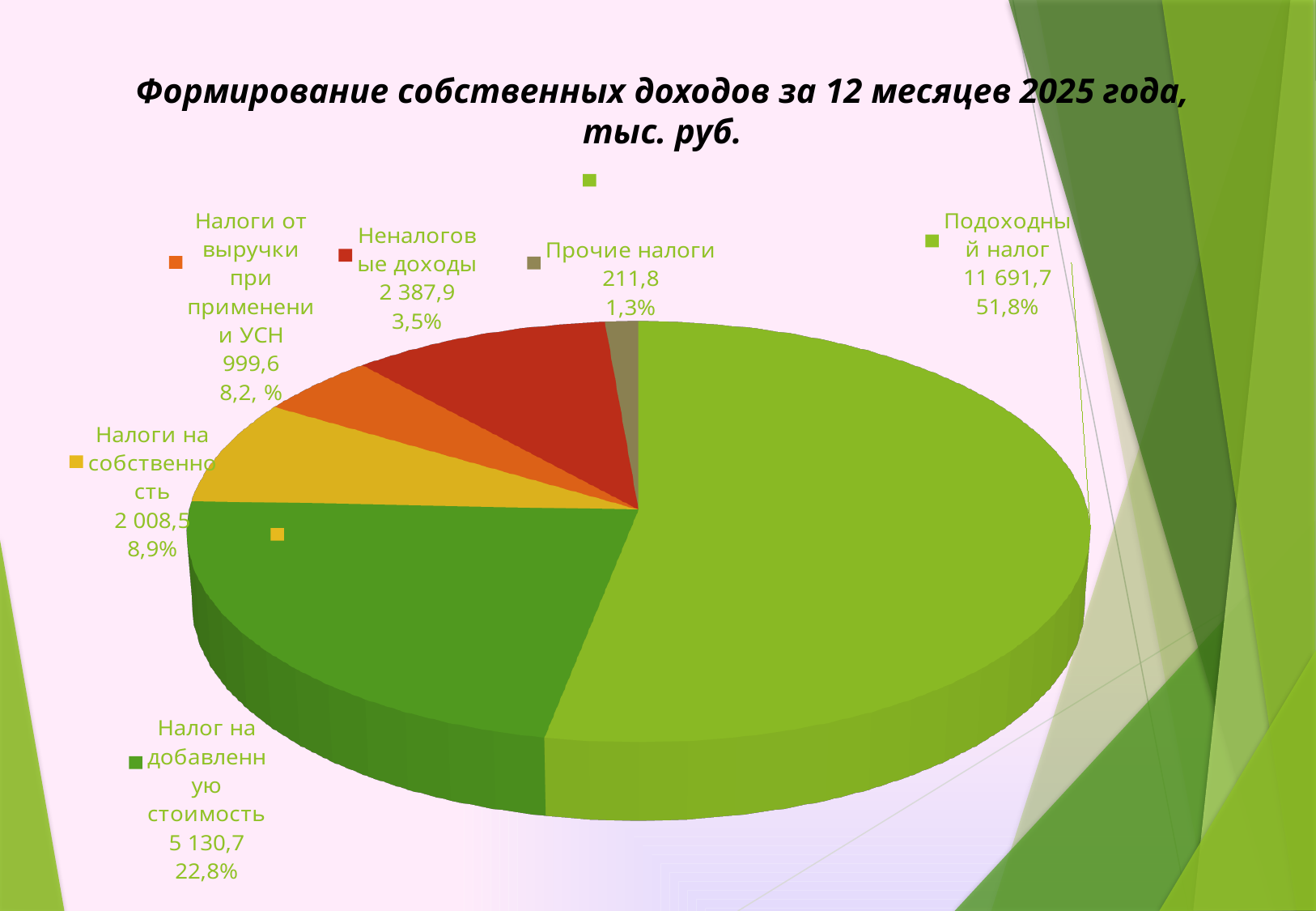
What is the value for Налог на добавленную стоимость? 5 130,7 What is the value for Прочие налоги? 211,8 Which is larger: Неналоговые доходы or Налоги на собственность? Неналоговые доходы What is the value for Неналоговые доходы? 2 387,9 Which category has the smallest slice? Прочие налоги What kind of chart is shown on the slide? Pie chart What is the value for Подоходный налог? 11 691,7 What share of the pie does Подоходный налог represent? 51,8% What is the title of the chart? Формирование собственных доходов за 12 месяцев 2025 года, тыс. руб. What is the difference between the values for Подоходный налог and Налог на добавленную стоимость? 6 561,0 Which category has the largest slice? Подоходный налог How many slices does the pie chart have? 6